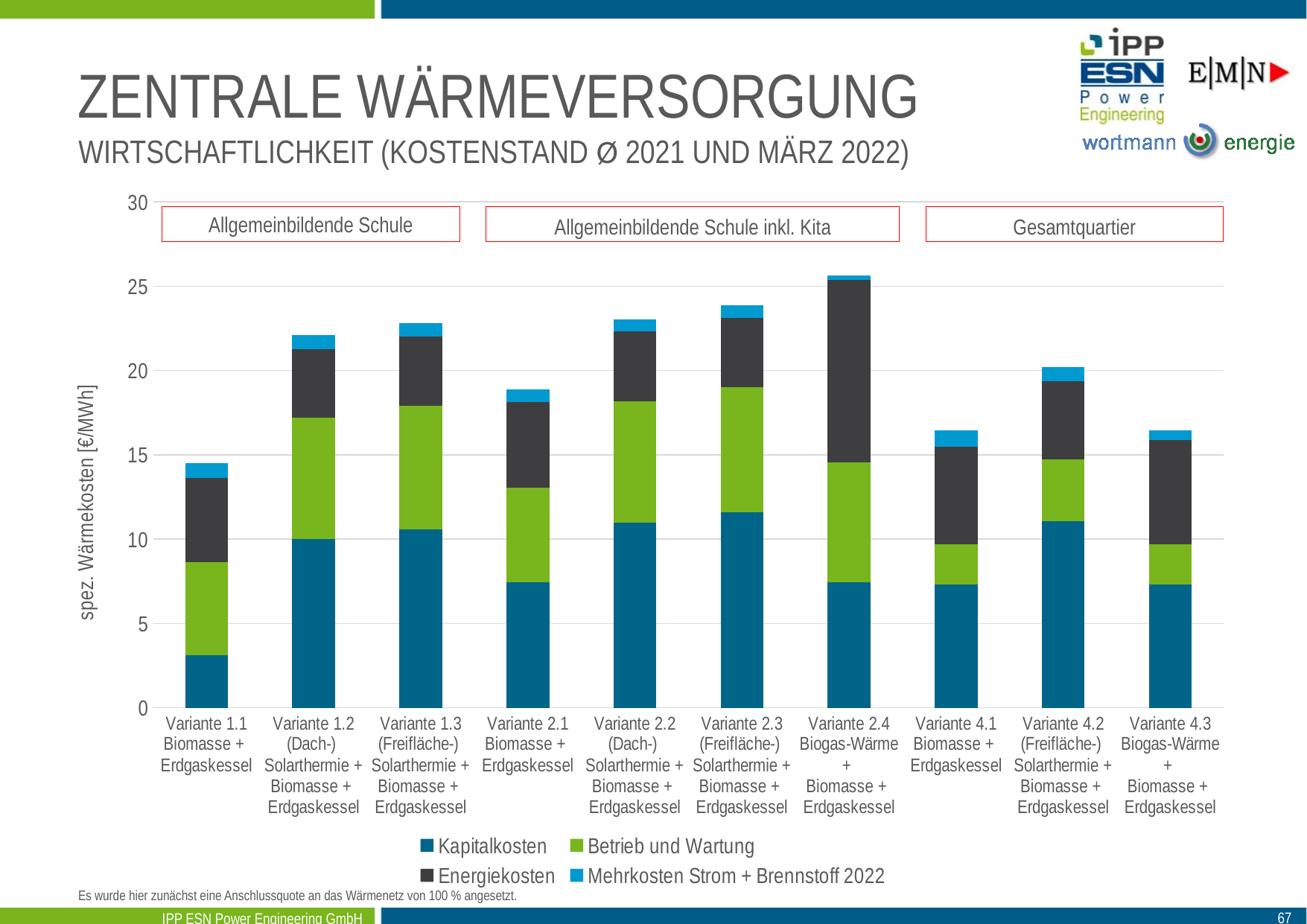
Is the total value for Variante 2.4 greater or less than 25? greater Which has the larger total specific heat cost, Variante 1.2 or Variante 2.1? Variante 1.2 Is the Kapitalkosten value for Variante 1.1 greater or less than 5? less What kind of chart is shown on the slide? Stacked bar chart Which variant has the highest total specific heat cost? Variante 2.4 Biogas-Wärme + Biomasse + Erdgaskessel How many variants (categories) are plotted along the x axis? 10 Is the total value for Variante 2.1 greater or less than 20? less How many series does the legend list? 4 What is the label of the y axis? spez. Wärmekosten [€/MWh] Which variant has the lowest total specific heat cost? Variante 1.1 Biomasse + Erdgaskessel Which legend entry is shown in light blue? Mehrkosten Strom + Brennstoff 2022